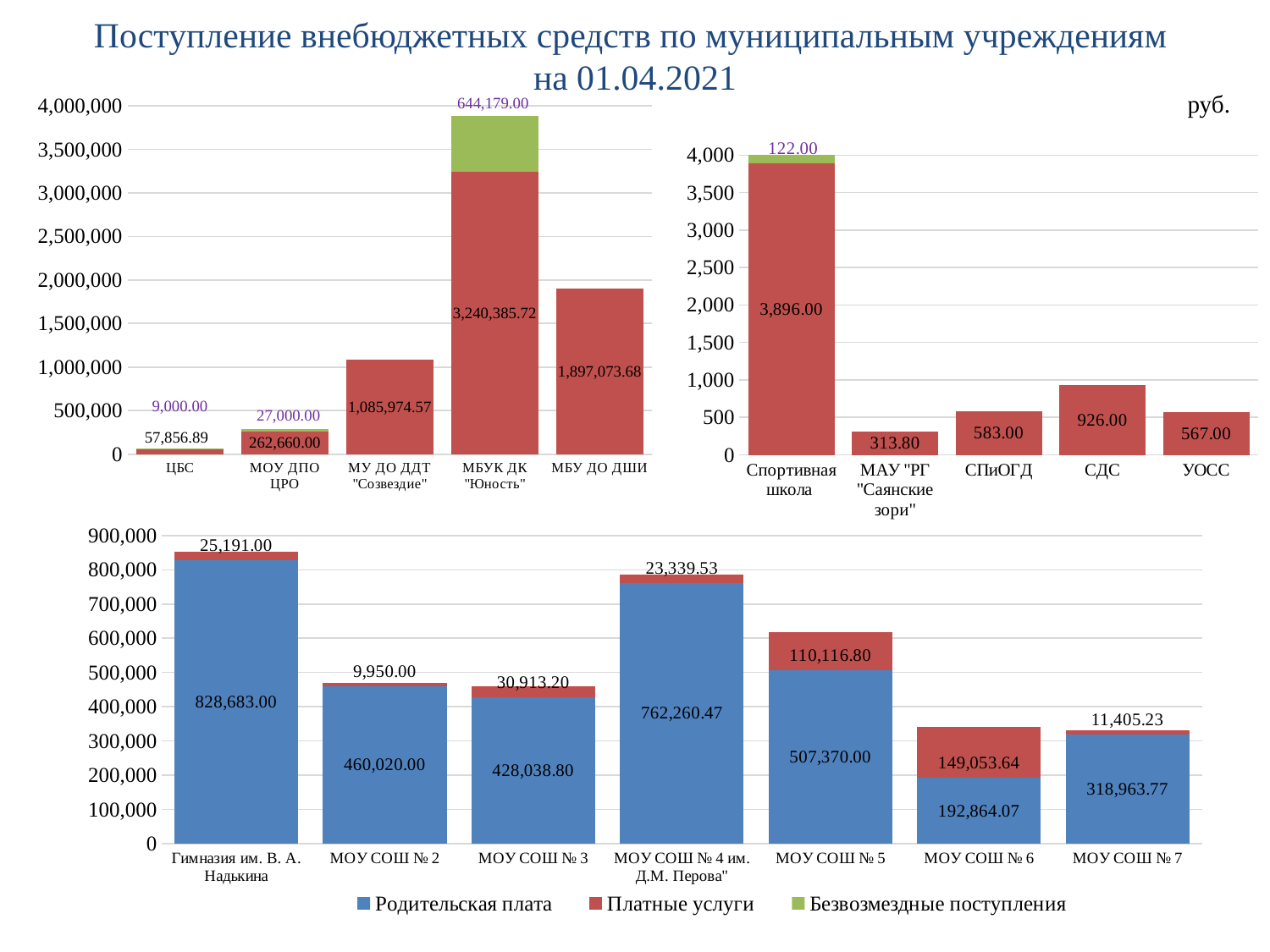
In the top-right chart, what is the difference between the values for СДС and УОСС? 359.00 In the top-right chart, which category has the lowest value? МАУ "РГ "Саянские зори" In the bottom chart, how many categories are shown on the x axis? 7 In the bottom chart, which category has the highest value of Платные услуги? МОУ СОШ № 6 How many series does the legend at the bottom of the slide list? 3 In the bottom chart, what is the total of the stacked bar for Гимназия им. В. А. Надькина? 853,874.00 In the bottom chart, is the value of Родительская плата larger for МОУ СОШ № 2 or МОУ СОШ № 3? МОУ СОШ № 2 In the top-left chart, what is the value of Платные услуги for МБУК ДК "Юность"? 3,240,385.72 In the top-left chart, what is the value of Безвозмездные поступления for МОУ ДПО ЦРО? 27,000.00 In the bottom chart, what is the value of Родительская плата for МОУ СОШ № 4 им. Д.М. Перова"? 762,260.47 In the top-left chart, what is the total of the stacked bar for МБУК ДК "Юность"? 3,884,564.72 In the top-right chart, what is the total of the stacked bar for Спортивная школа? 4,018.00